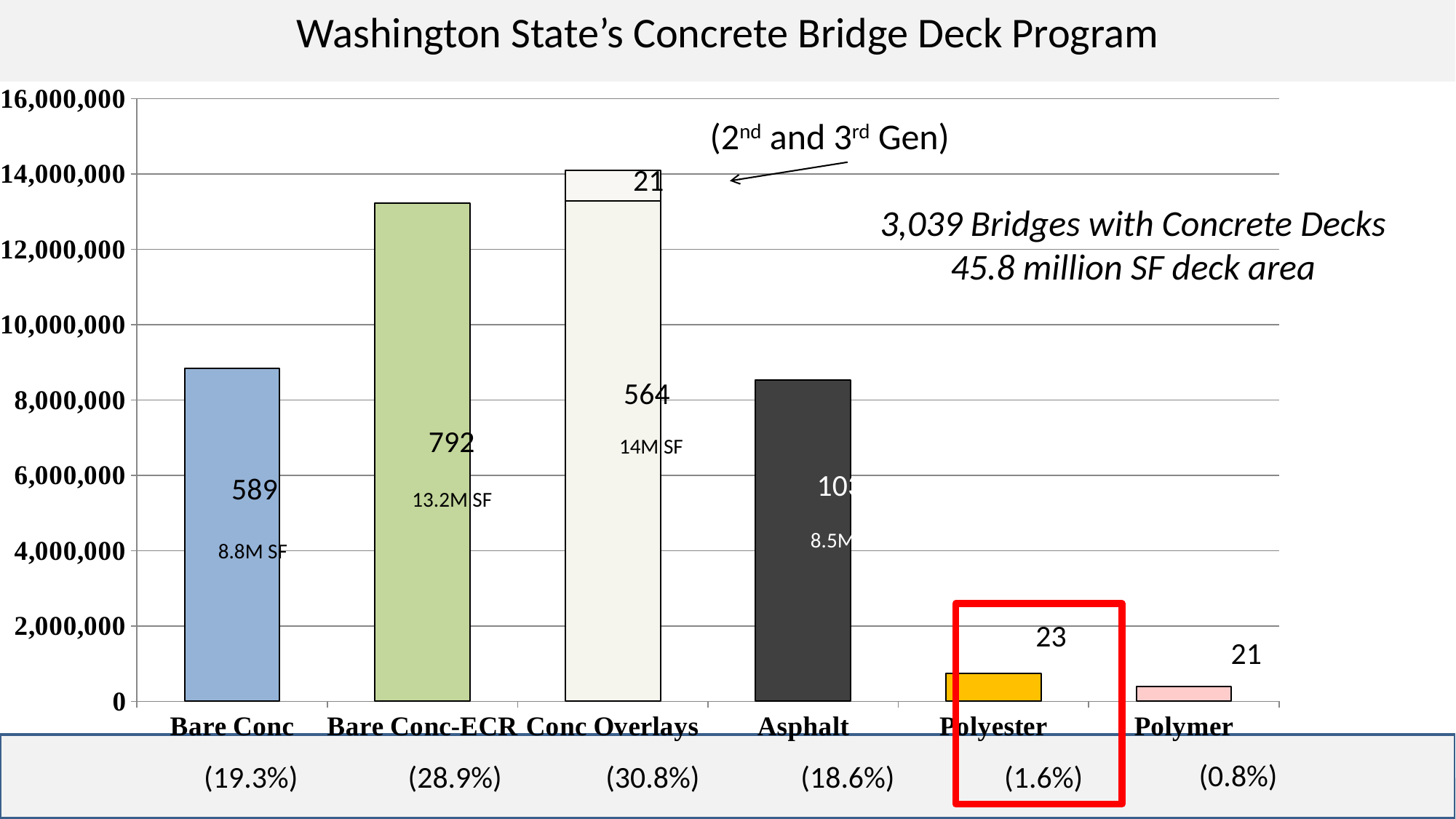
What deck area label is printed on the Bare Conc-ECR bar? 13.2M SF Is the value for Bare Conc-ECR greater or less than 12,000,000? greater What percentage is shown below the Conc Overlays category? 30.8% What number is printed on the Bare Conc bar? 589 Which category's bar is outlined with a red box on the slide? Polyester Which category has the tallest bar in the chart? Conc Overlays What kind of chart is shown on the slide? bar chart How many categories are shown along the x axis of the chart? 6 What number is printed above the Polyester bar? 23 What number is printed on the Bare Conc-ECR bar? 792 Which category has the shortest bar in the chart? Polymer Is the value for Polyester greater or less than 2,000,000? less